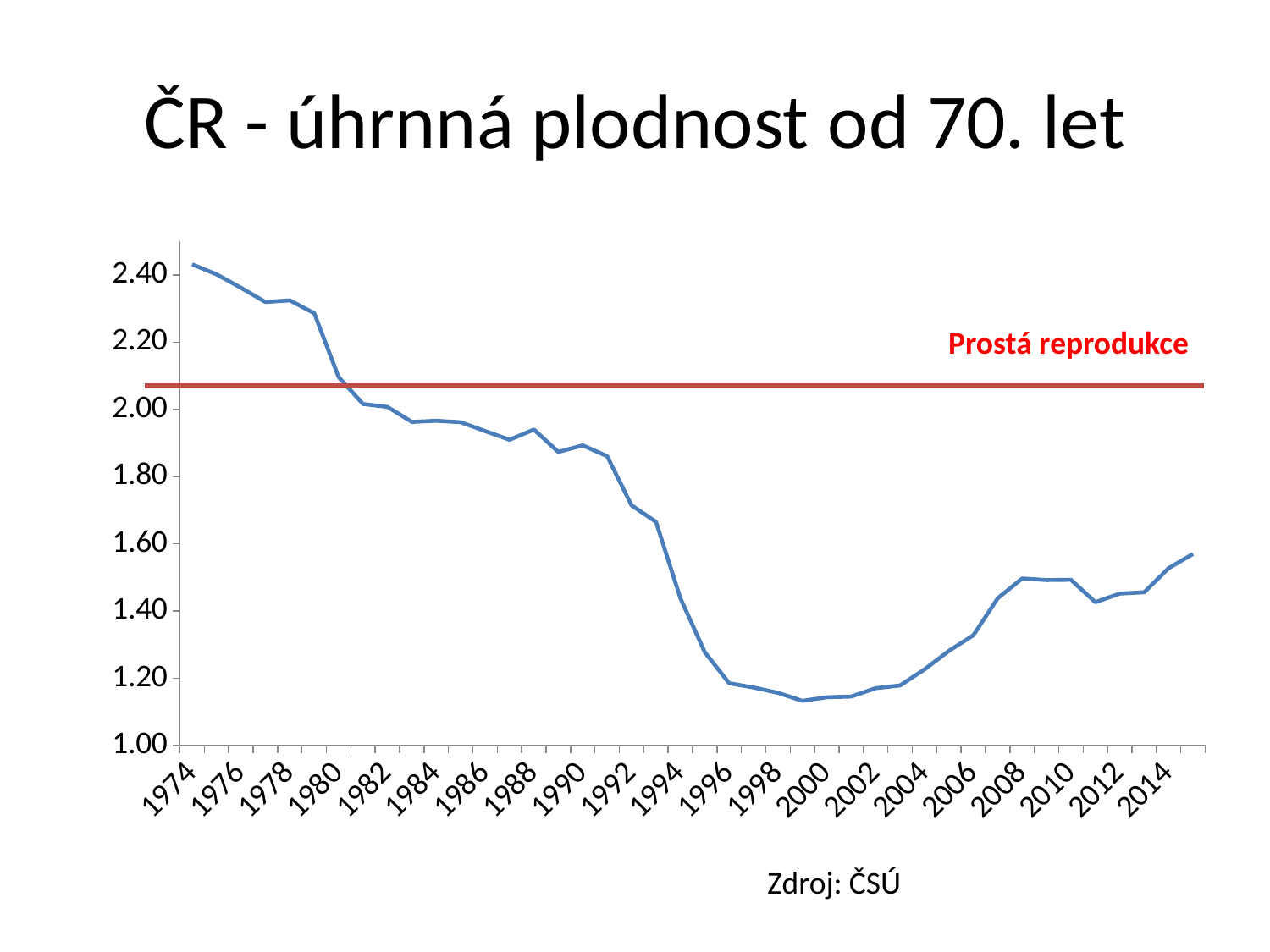
Which year has the larger value, 1974 or 2014? 1974 Is the value for 1990 greater or less than 2.00? less Is the value for 1992 greater or less than 1.80? less In which year is the plotted value highest? 1974 What kind of chart is shown on the slide? line chart Is the value for 2000 greater or less than 1.20? less Do the values rise or fall between 1990 and 2000? fall What label is given to the red horizontal line in the chart? Prostá reprodukce Do the values rise or fall between 2004 and 2008? rise What is the title of the chart on the slide? ČR - úhrnná plodnost od 70. let